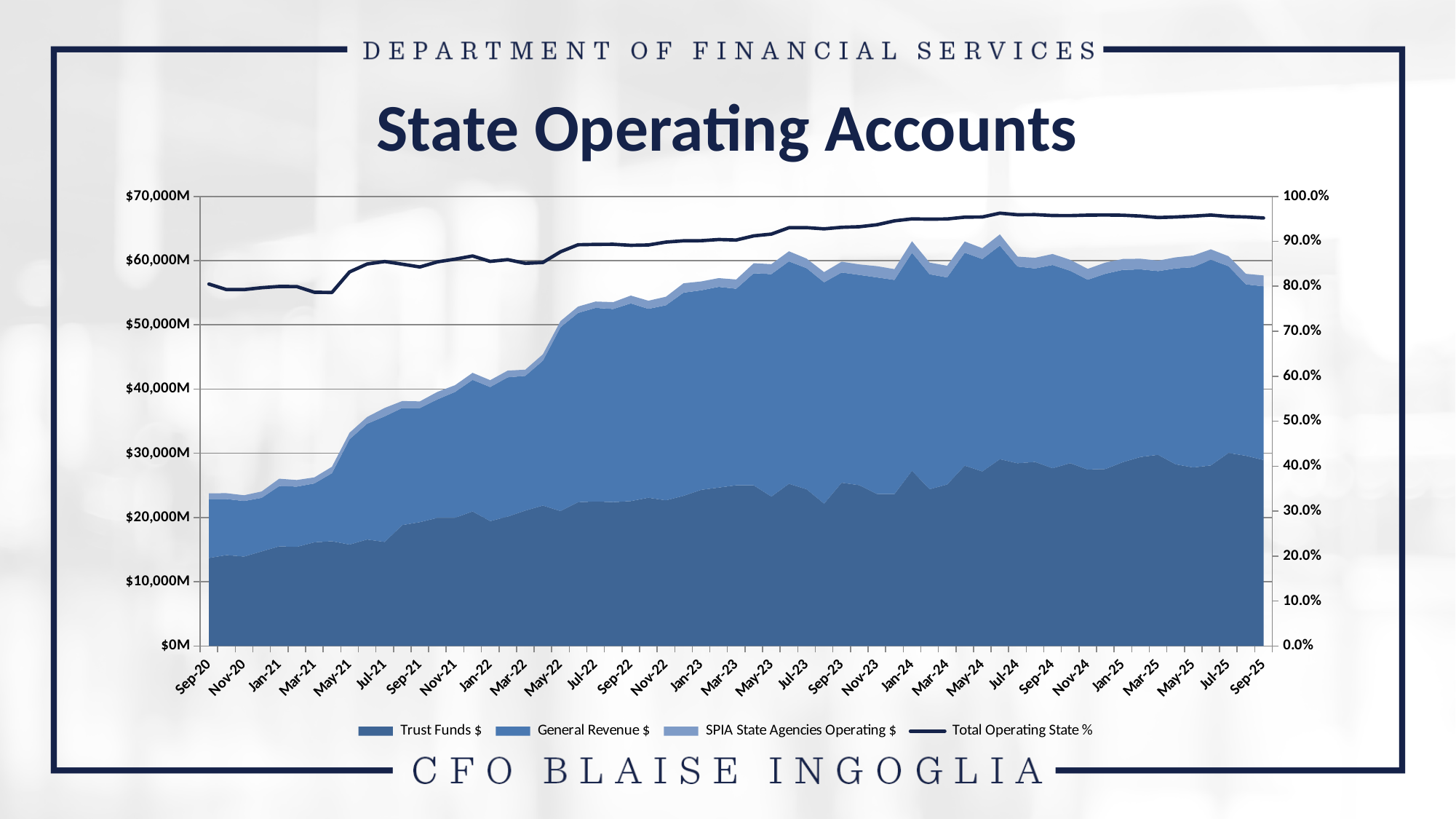
How many series does the legend list? 4 Does the total of the stacked areas rise or fall overall from Sep-20 to Sep-25? Rise Is the Total Operating State % value at Sep-25 greater or less than 90.0%? greater Which is larger, the Total Operating State % at Sep-20 or at Sep-25? Sep-25 Is the combined total of the stacked areas at Sep-20 greater or less than $30,000M? less Is the combined total of the stacked areas at Sep-25 greater or less than $50,000M? greater Does the Total Operating State % line rise or fall overall from Sep-20 to Sep-25? Rise Which series is plotted as a line rather than an area? Total Operating State % What is the title of the chart? State Operating Accounts What kind of chart is shown on the slide? Stacked area chart with a line